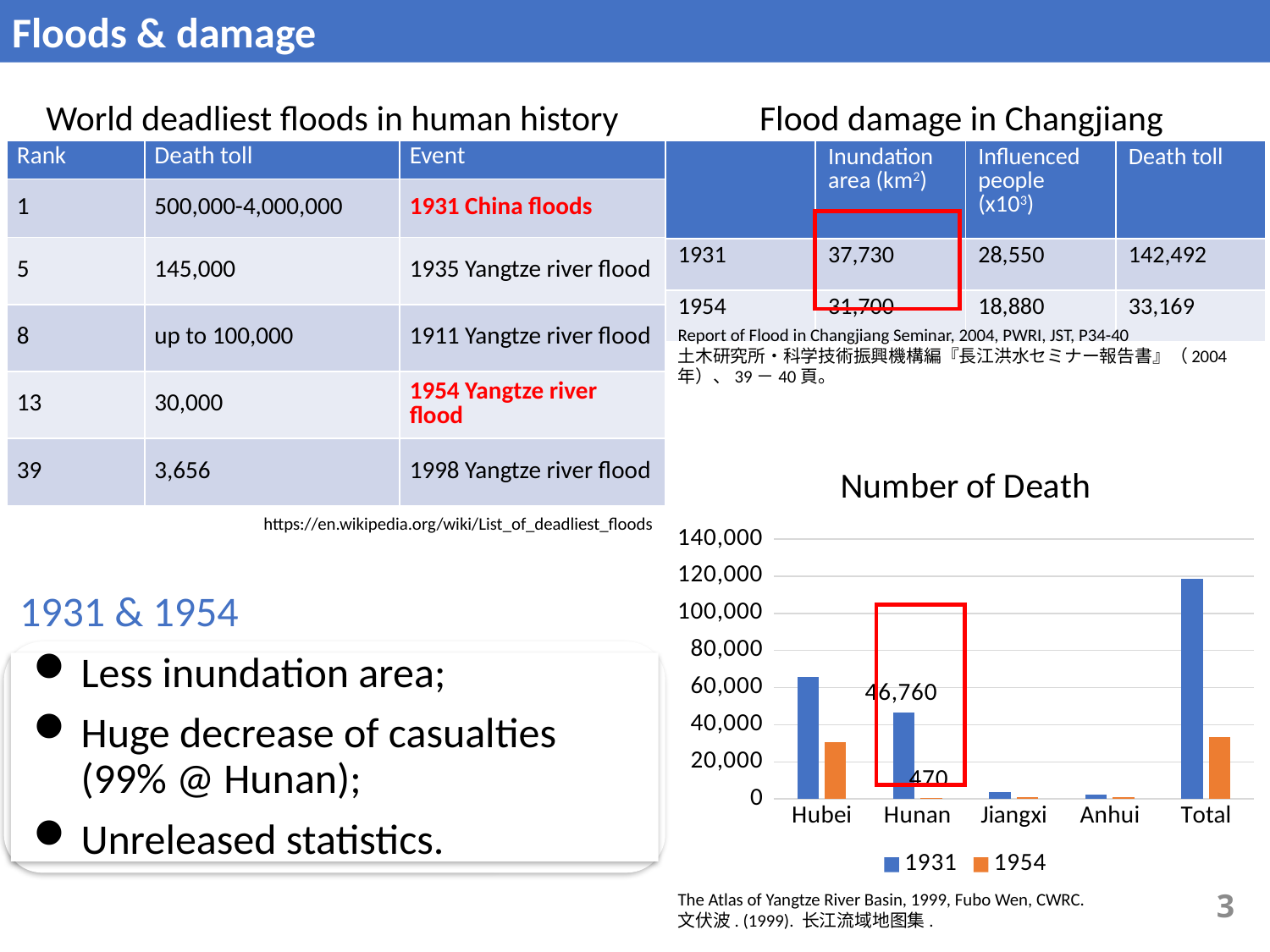
In the "Number of Death" chart, is the 1931 value for Total greater or less than 100,000? greater In the "Number of Death" chart, what is the value for Hunan in 1931? 46,760 In the "Number of Death" chart, what is the value for Hunan in 1954? 470 What kind of chart is the "Number of Death" chart? bar chart What is the title of the chart on the slide? Number of Death In the "Number of Death" chart, is the 1931 value for Hubei greater or less than 80,000? less In the "Number of Death" chart, what is the difference between the 1931 and 1954 values for Hunan? 46,290 What are the two legend entries of the "Number of Death" chart? 1931 and 1954 In the "Number of Death" chart, which category has the highest 1931 value? Total How many series does the legend of the "Number of Death" chart list? 2 How many categories are shown on the x axis of the "Number of Death" chart? 5 In the "Number of Death" chart, which is larger for Hubei: the 1931 value or the 1954 value? 1931